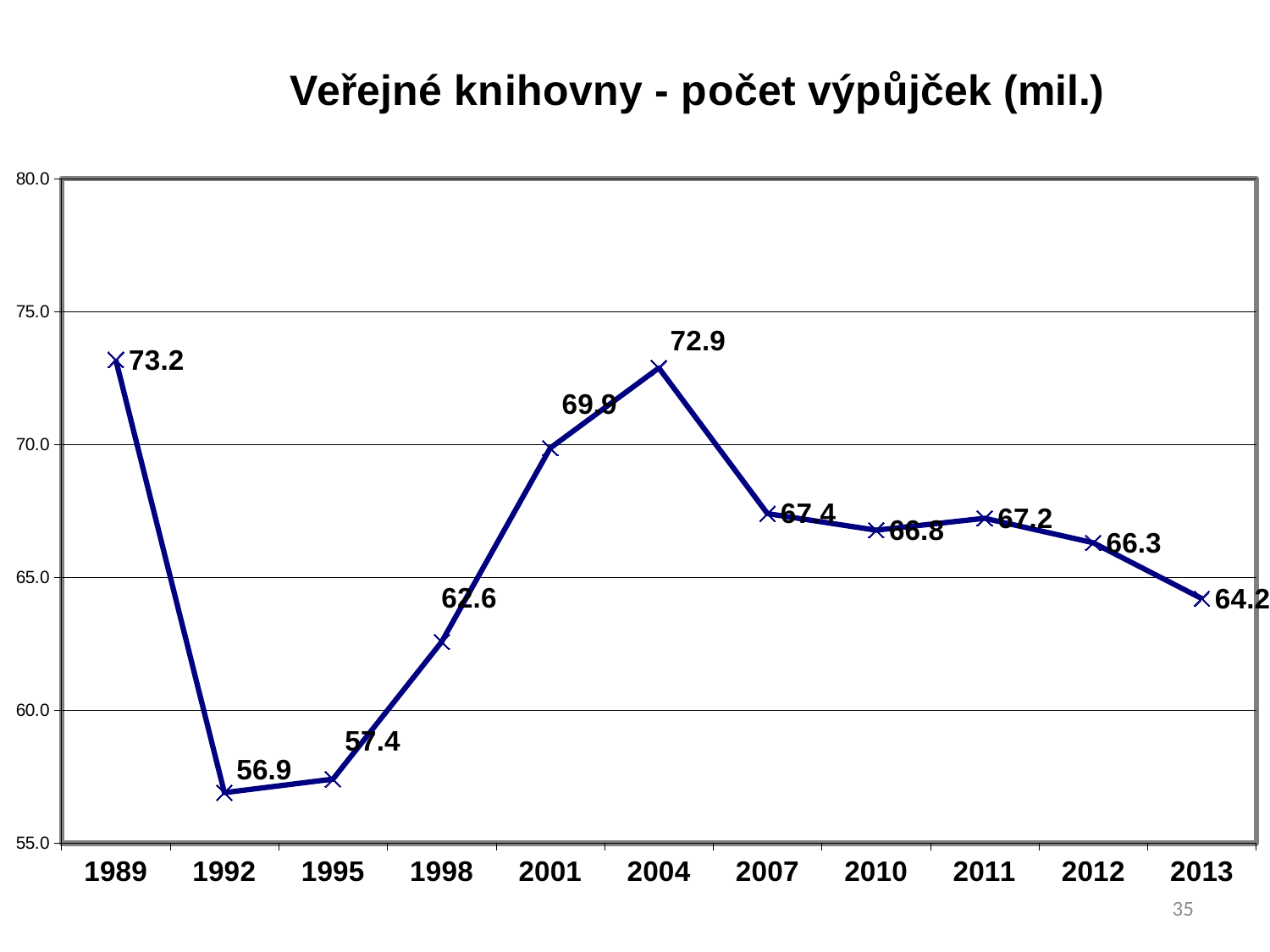
What kind of chart is this? line chart How many years are plotted on the x axis? 11 Which is larger, the value for 2001 or the value for 2007? 2001 Which year has the highest value? 1989 What is the value for 1989? 73.2 Do the values rise or fall from 2004 to 2013? fall Which year has the lowest value? 1992 What is the value for 2013? 64.2 What is the value for 2004? 72.9 What is the difference between the values for 1989 and 1992? 16.3 What is the title of the chart? Veřejné knihovny - počet výpůjček (mil.) Is the value for 1998 greater or less than 65.0? less